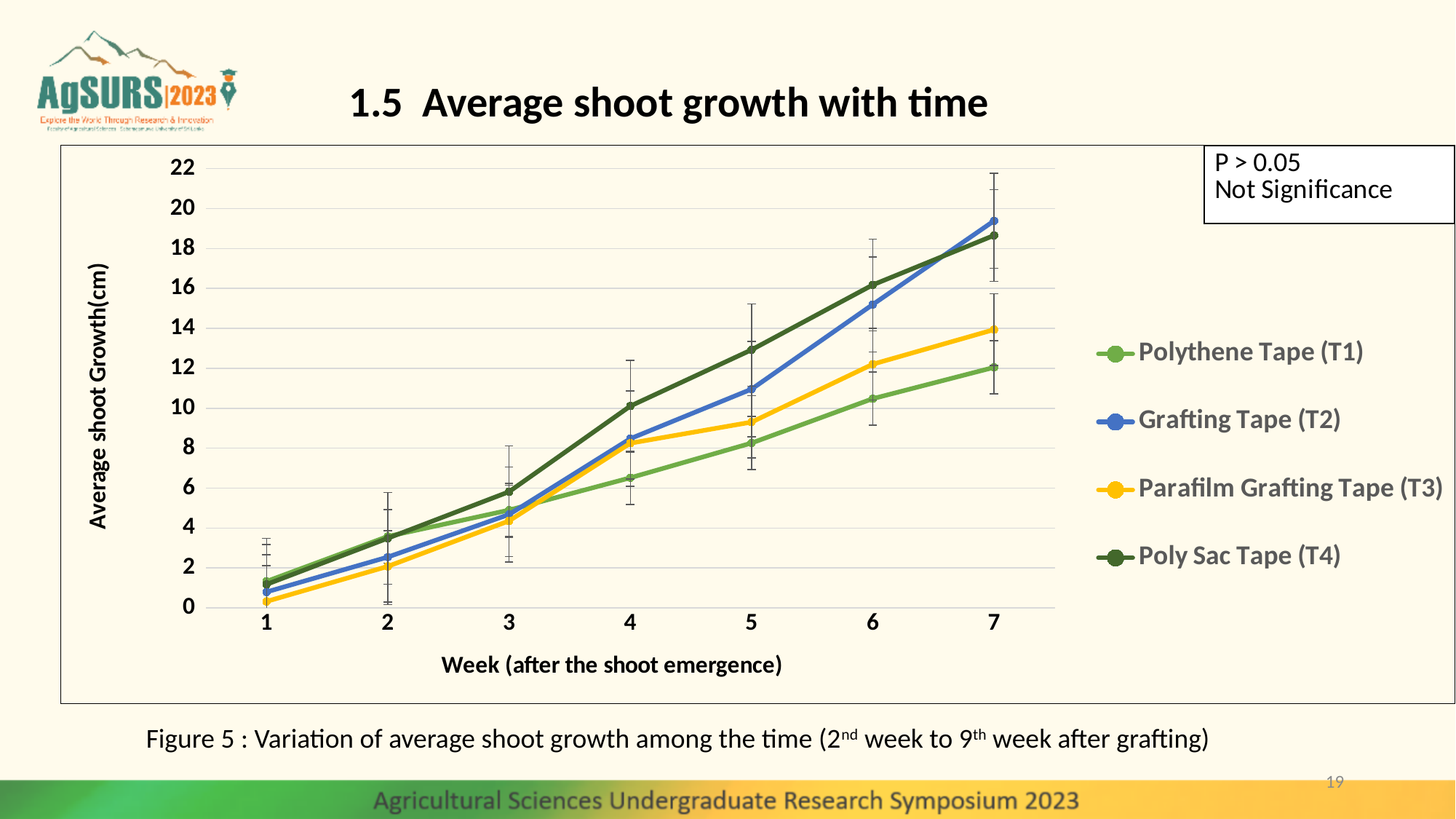
Is the value for Parafilm Grafting Tape (T3) at week 2 greater or less than 4? less Which series has the highest average shoot growth at week 6? Poly Sac Tape (T4) Do the average shoot growth values rise or fall from week 1 to week 7? rise How many weeks are plotted along the x axis? 7 Is the value for Grafting Tape (T2) at week 7 greater or less than 16? greater Is the value for Polythene Tape (T1) at week 7 greater or less than 14? less At week 5, which is larger: Poly Sac Tape (T4) or Parafilm Grafting Tape (T3)? Poly Sac Tape (T4) What kind of chart is shown on the slide? line chart What is the title of the x axis? Week (after the shoot emergence) How many series does the legend list? 4 Which series has the lowest average shoot growth at week 7? Polythene Tape (T1)